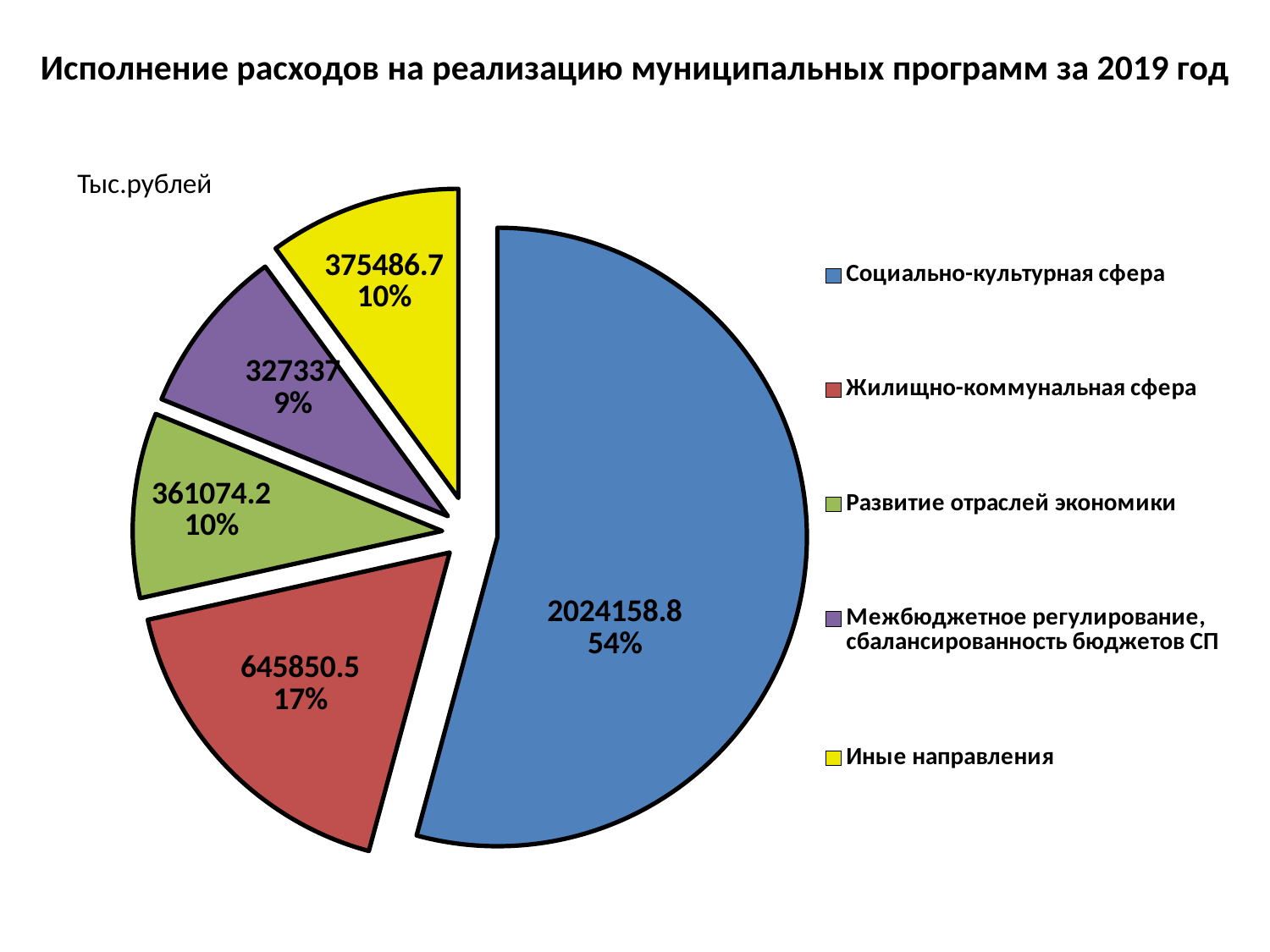
What is the value for Межбюджетное регулирование, сбалансированность бюджетов СП? 327337 What unit is indicated for the values on the chart? Тыс.рублей Which category has the smallest slice? Межбюджетное регулирование, сбалансированность бюджетов СП What type of chart is shown on the slide? Pie chart What share of the pie does Жилищно-коммунальная сфера represent? 17% What is the difference between the values for Жилищно-коммунальная сфера and Развитие отраслей экономики? 284776.3 Which category has the largest slice? Социально-культурная сфера What is the value for Жилищно-коммунальная сфера? 645850.5 How many categories does the pie chart have? 5 What is the value for Социально-культурная сфера? 2024158.8 Which is larger: the value for Иные направления or the value for Развитие отраслей экономики? Иные направления What share of the pie does Социально-культурная сфера represent? 54%